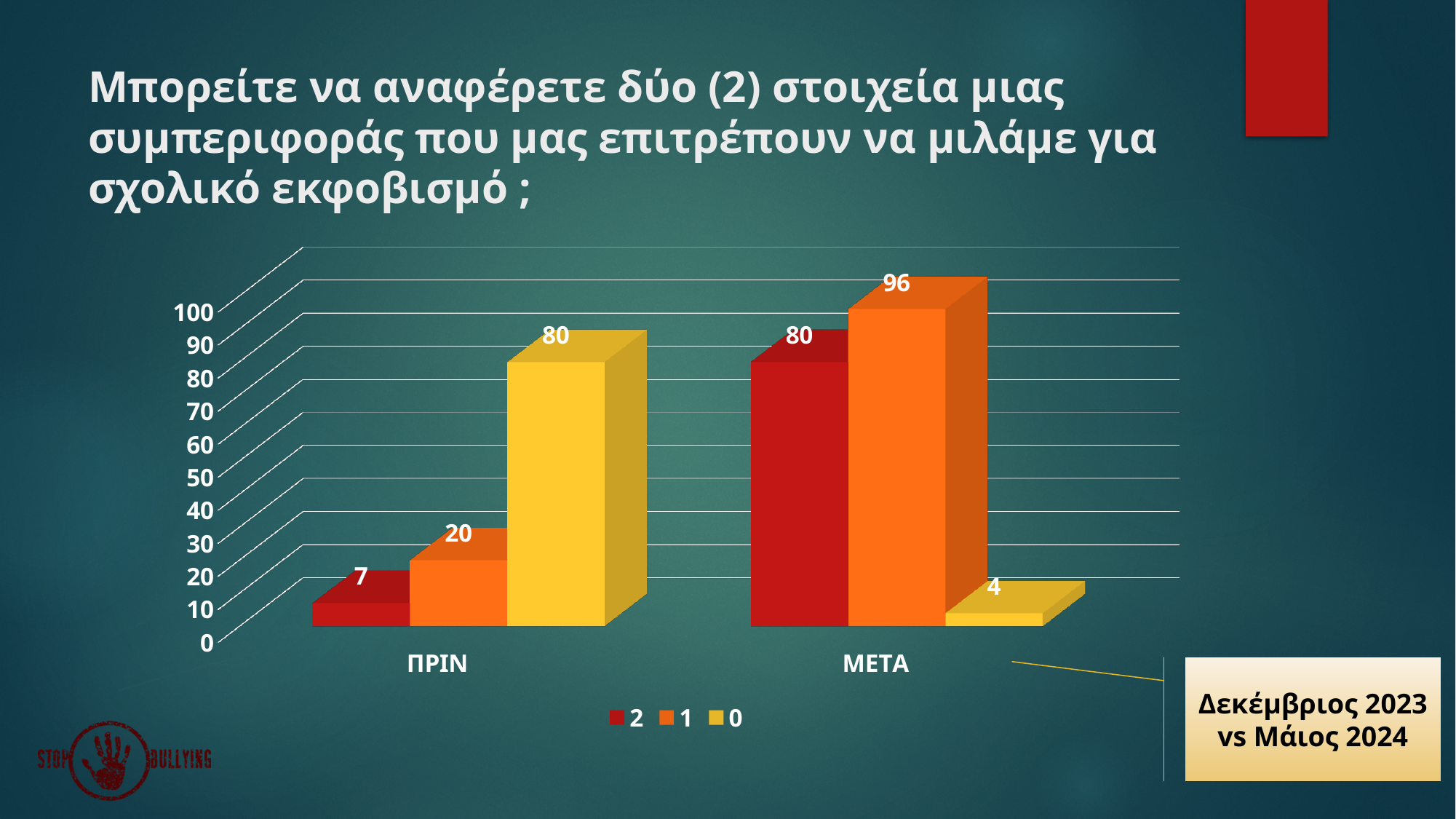
What kind of chart is shown on the slide? Bar chart Which is larger: the value for series "2" in ΠΡΙΝ or in ΜΕΤΑ? ΜΕΤΑ What is the difference between the value for series "1" in ΜΕΤΑ and in ΠΡΙΝ? 76 What does the text box at the bottom right of the slide say? Δεκέμβριος 2023 vs Μάιος 2024 What is the value for series "2" in the ΠΡΙΝ category? 7 What is the value for series "1" in the ΜΕΤΑ category? 96 What is the value for series "0" in the ΠΡΙΝ category? 80 Which series has the highest value in the ΜΕΤΑ category? 1 What is the value for series "0" in the ΜΕΤΑ category? 4 How many series does the legend list? 3 How many categories are shown on the x axis? 2 Which series has the lowest value in the ΠΡΙΝ category? 2